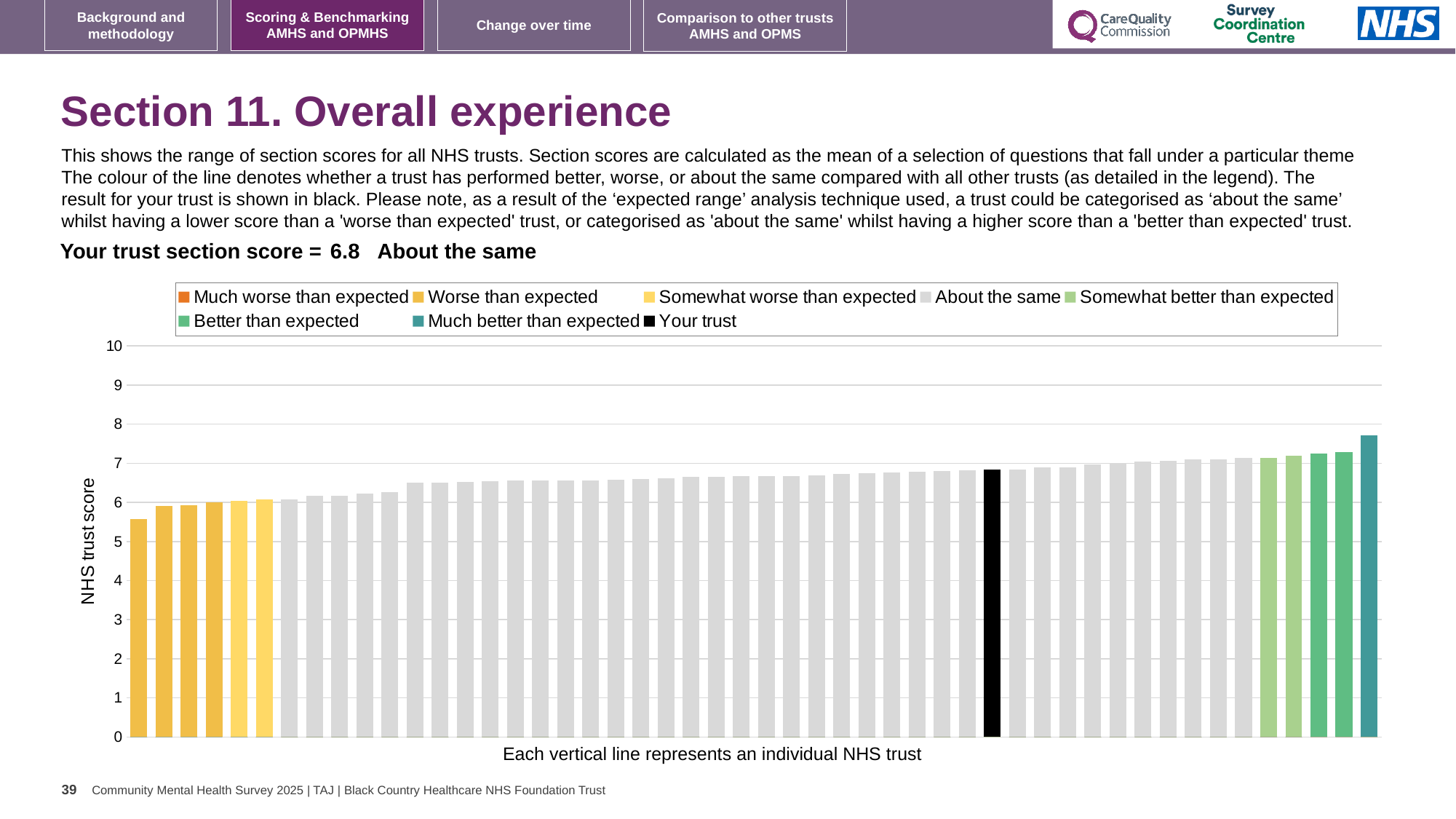
How many entries does the chart legend list? 8 Is the value of the shortest bar (the first bar on the left) greater or less than 5? greater Which category is the trust's section score placed in? About the same What is the trust section score shown on the slide? 6.8 What is the label on the vertical axis of the chart? NHS trust score Do the bar values rise or fall from left to right across the chart? Rise What is the highest tick value shown on the vertical axis? 10 What kind of chart is shown on the slide? Bar chart Is the value of the shortest bar (the first bar on the left) greater or less than 6? less According to the legend, which category does the colour of the tallest bar (teal) represent? Much better than expected Is the value of the tallest bar (the teal one at the far right) greater or less than 7? greater